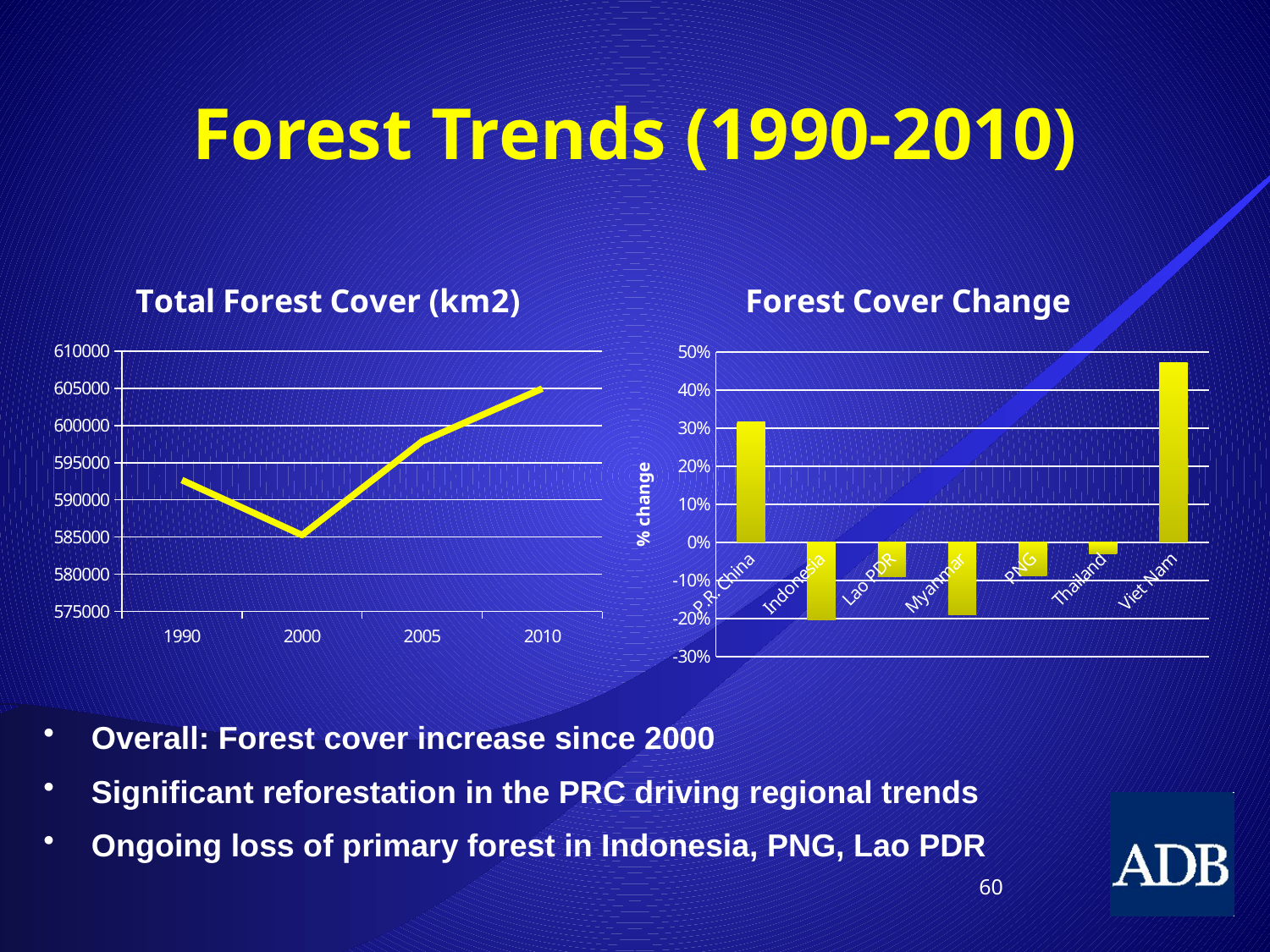
In the Forest Cover Change chart, which is larger, the value for P.R. China or the value for Viet Nam? Viet Nam In the Forest Cover Change chart, is the value for Indonesia greater or less than -10%? less In the Forest Cover Change chart, is the value for P.R. China greater or less than 20%? greater In the Total Forest Cover (km2) chart, is the value for 2000 greater or less than 590000? less What kind of chart is the Forest Cover Change chart? bar chart In the Forest Cover Change chart, how many countries are shown? 7 In the Forest Cover Change chart, which country has the highest percentage change? Viet Nam What kind of chart is the Total Forest Cover (km2) chart? line chart In the Total Forest Cover (km2) chart, does the value rise or fall from 2000 to 2010? rise What is the y-axis label of the Forest Cover Change chart? % change In the Total Forest Cover (km2) chart, how many years are plotted on the x axis? 4